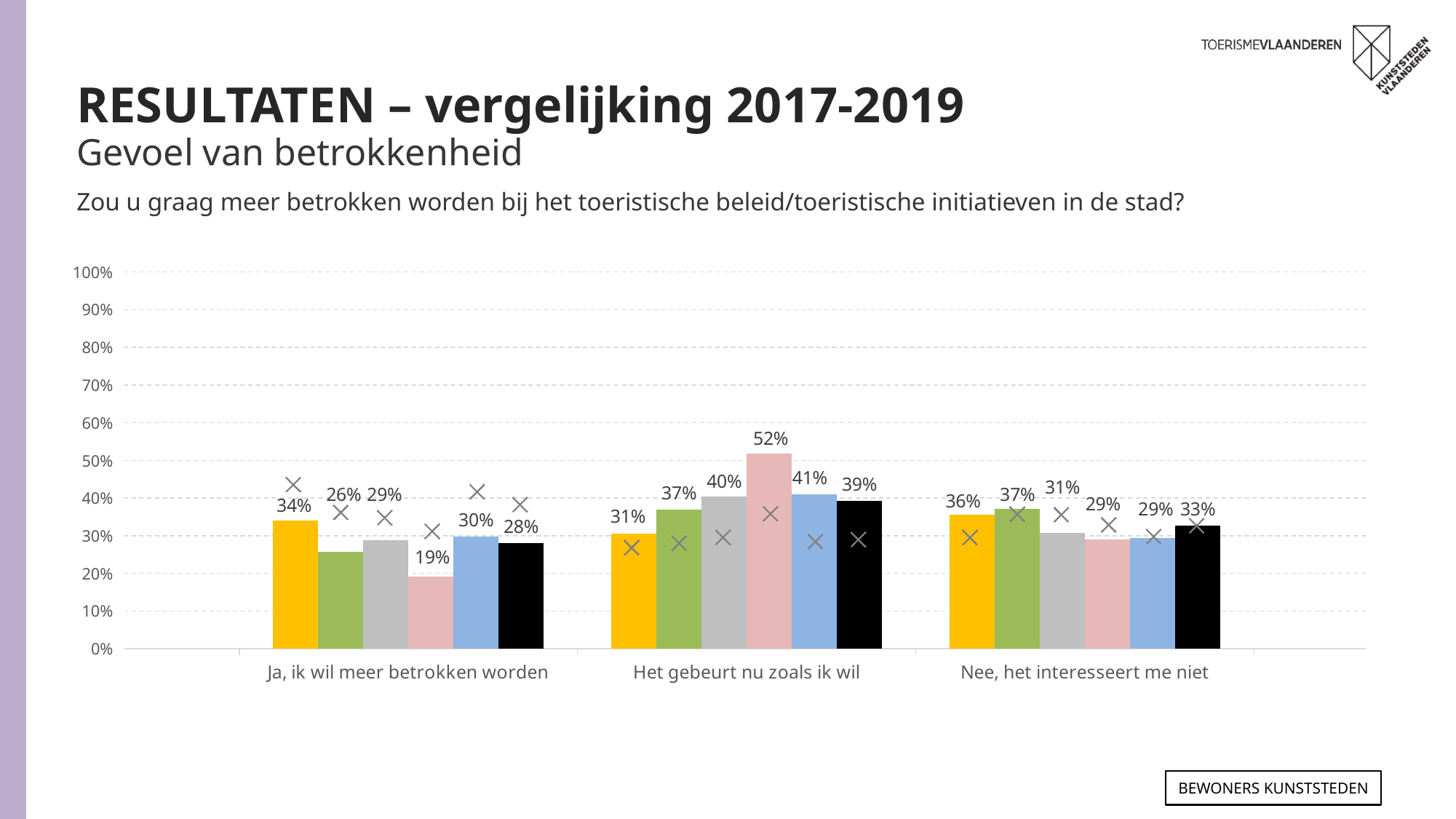
What kind of chart is shown on the slide? Bar chart Which category has the highest pink bar? Het gebeurt nu zoals ik wil What is the value of the yellow bar for "Het gebeurt nu zoals ik wil"? 31% How many categories are shown on the x axis? 3 What is the value of the pink bar for "Het gebeurt nu zoals ik wil"? 52% What is the value of the black bar for "Nee, het interesseert me niet"? 33% Which coloured bar is the lowest in the "Ja, ik wil meer betrokken worden" group? The pink bar (19%) What is the value of the pink bar for "Ja, ik wil meer betrokken worden"? 19% What is the highest value shown on the chart? 52% What is the difference between the pink bar (52%) and the yellow bar (31%) for "Het gebeurt nu zoals ik wil"? 21 percentage points Is the yellow bar larger for "Ja, ik wil meer betrokken worden" or for "Nee, het interesseert me niet"? Nee, het interesseert me niet Is the value of the pink bar for "Het gebeurt nu zoals ik wil" greater or less than 50%? greater